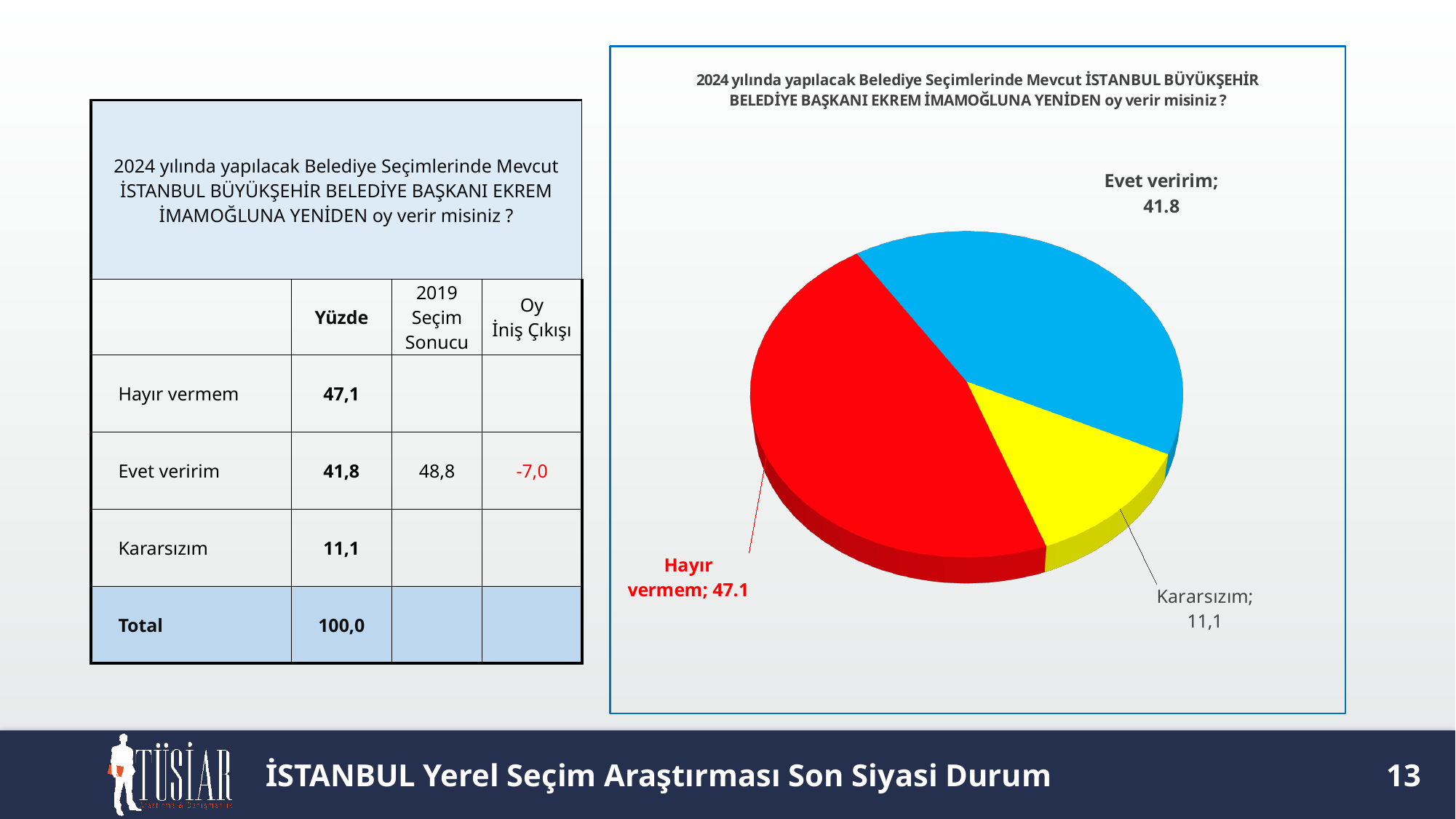
What kind of chart is shown on the slide? Pie chart How many slices does the pie chart have? 3 Which slice of the pie chart is the smallest? Kararsızım What is the difference between the "Evet veririm" and "Kararsızım" values in the pie chart? 30.7 What is the value shown for the "Evet veririm" slice of the pie chart? 41.8 Which is larger in the pie chart, "Evet veririm" or "Hayır vermem"? Hayır vermem What is the difference between the "Hayır vermem" and "Evet veririm" values in the pie chart? 5.3 What is the value shown for the "Kararsızım" slice of the pie chart? 11,1 Which slice of the pie chart is the largest? Hayır vermem What colour is the "Hayır vermem" slice in the pie chart? Red What colour is the "Kararsızım" slice in the pie chart? Yellow What is the value shown for the "Hayır vermem" slice of the pie chart? 47.1